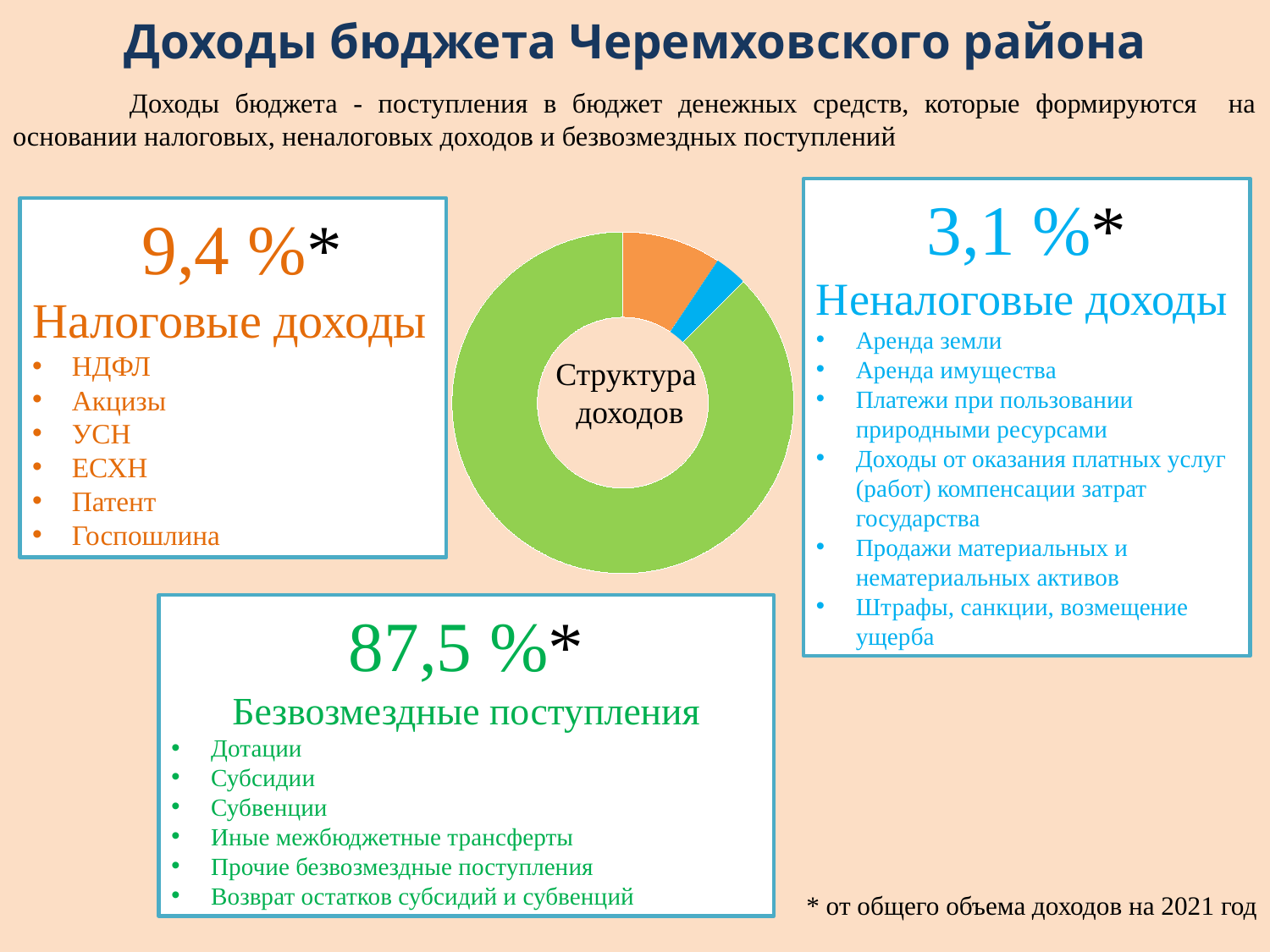
By how many percentage points does the share of Налоговые доходы exceed the share of Неналоговые доходы? 6,3 % Which income category has the largest slice in the donut chart? Безвозмездные поступления What type of chart is shown in the centre of the slide? Pie (donut) chart What colour is the largest slice of the donut chart? Green What is the title shown in the centre of the donut chart? Структура доходов What share of total income do Налоговые доходы make up? 9,4 % What share of total income do Безвозмездные поступления make up? 87,5 % Which income category has the smallest slice in the donut chart? Неналоговые доходы What share of total income do Неналоговые доходы make up? 3,1 % How many slices does the donut chart have? 3 By how many percentage points does the share of Безвозмездные поступления exceed the share of Налоговые доходы? 78,1 % Which is larger: the share of Налоговые доходы or the share of Неналоговые доходы? Налоговые доходы